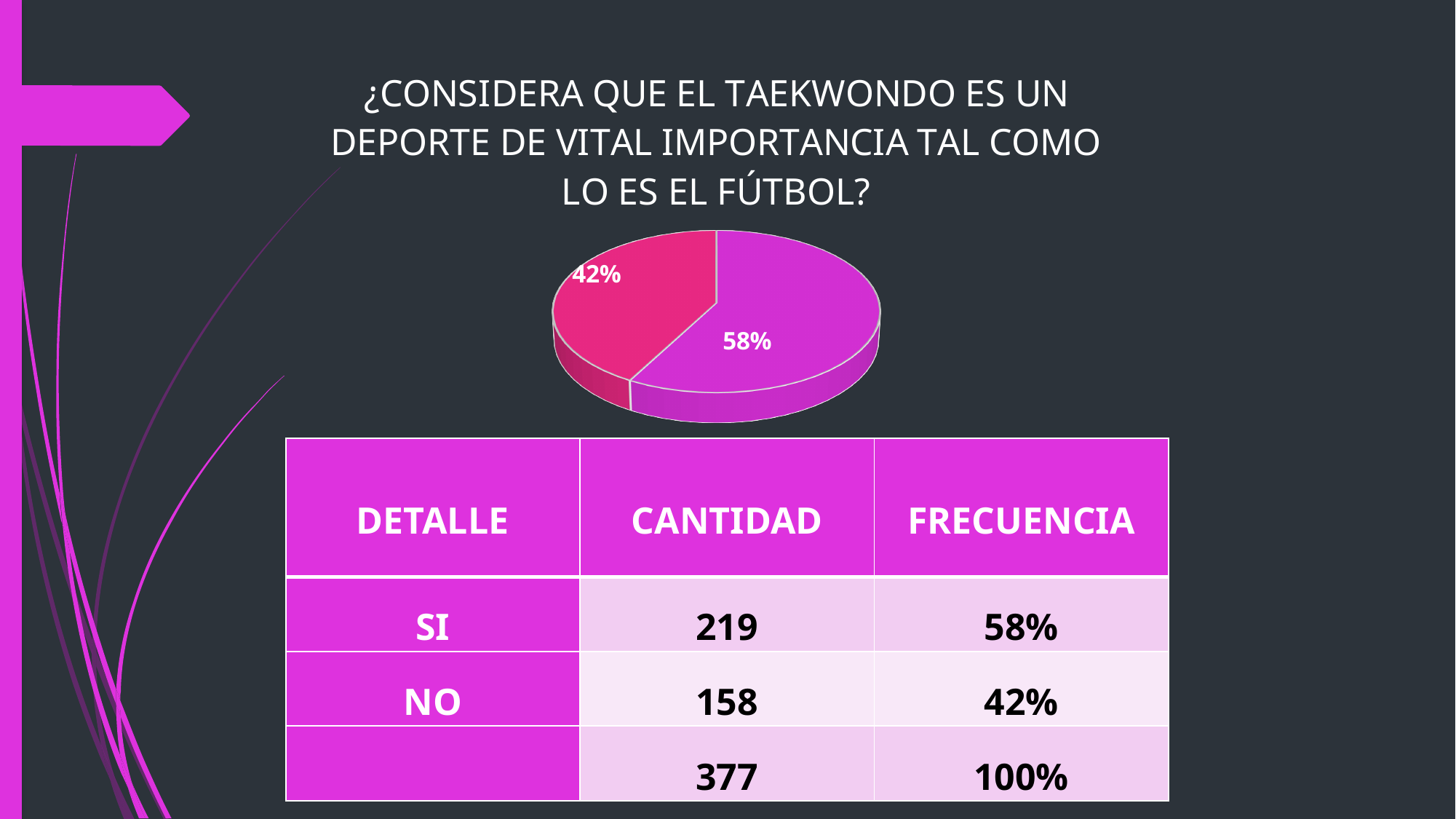
What percentage is shown on the larger slice of the pie chart? 58% How many slices does the pie chart have? 2 What is the title of the chart on the slide? ¿CONSIDERA QUE EL TAEKWONDO ES UN DEPORTE DE VITAL IMPORTANCIA TAL COMO LO ES EL FÚTBOL? What percentage is shown on the smaller slice of the pie chart? 42% What is the difference in percentage points between the 58% slice and the 42% slice? 16 Which response, SI or NO, has the larger slice in the pie chart? SI What kind of chart is shown on the slide? Pie chart What is the total CANTIDAD shown in the table for the survey? 377 According to the table, what share of the pie corresponds to NO? 42% Is the 58% slice larger or smaller than the 42% slice? Larger Which response, SI or NO, has the smaller slice in the pie chart? NO According to the table, what share of the pie corresponds to SI? 58%